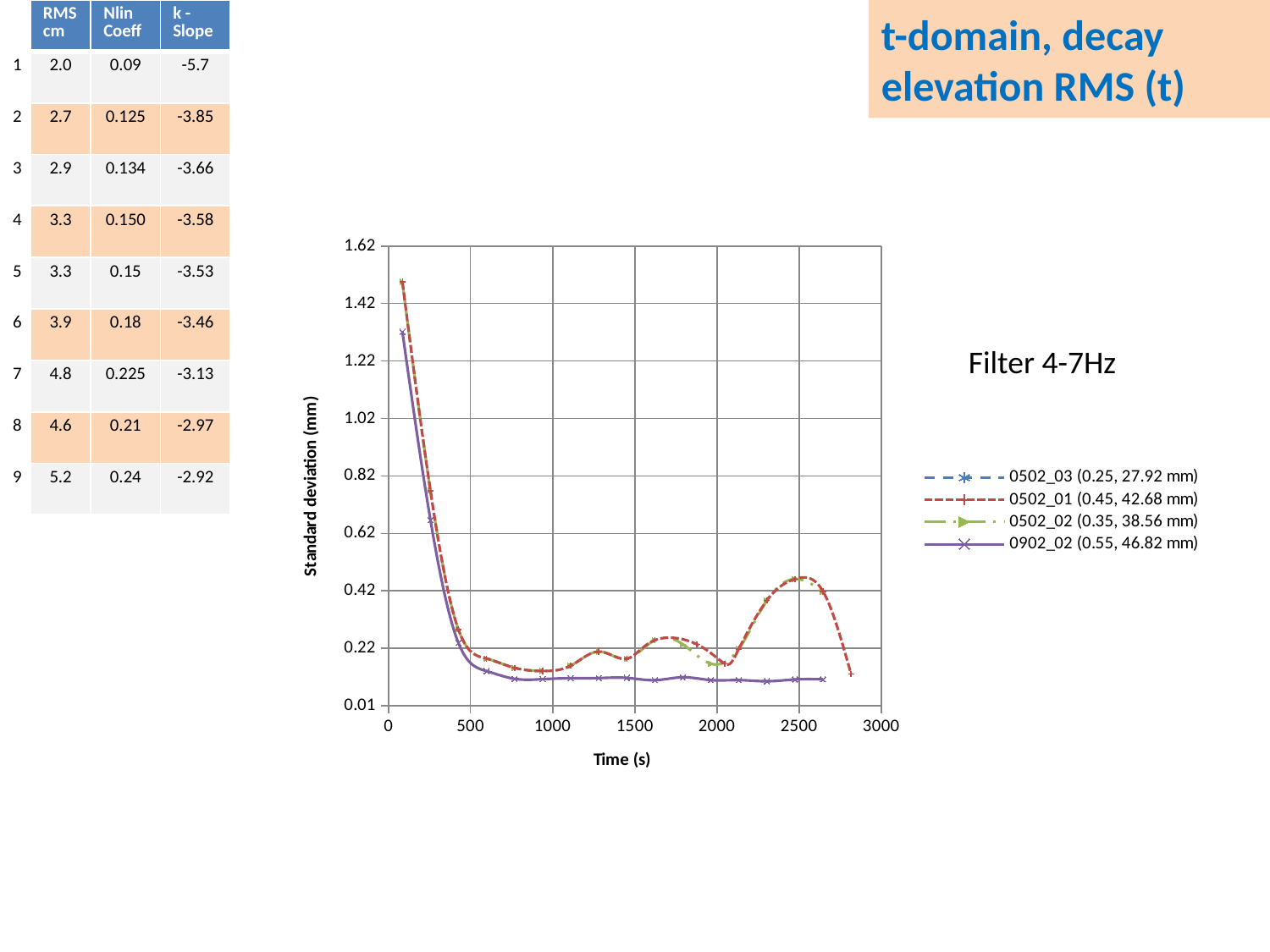
Is the first plotted value of series 0902_02 (near time 100 s) greater or less than 1.42? less Is the value for series 0502_01 at time 2500 s greater or less than 0.22? greater What is the label of the y axis of the chart? Standard deviation (mm) What is the label of the x axis of the chart? Time (s) Is the first plotted value of series 0502_01 (near time 100 s) greater or less than 1.42? greater Does the value of series 0902_02 rise or fall between time 0 and 1000 s? fall At time 2500 s, which series has the larger value: 0502_01 or 0902_02? 0502_01 What kind of chart is shown on the slide? line chart Which series has the lowest value at time 2500 s? 0902_02 How many series does the chart legend list? 4